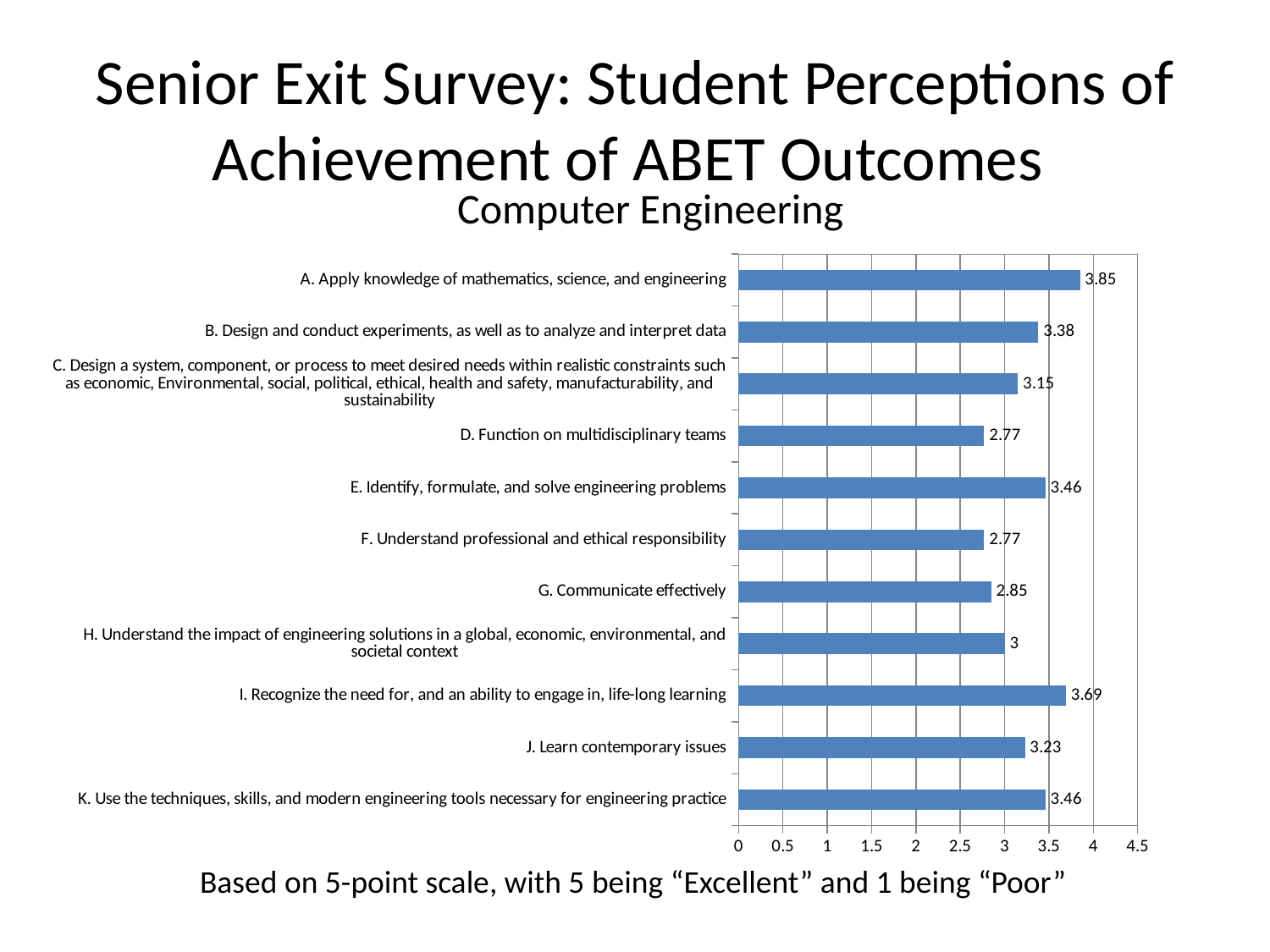
What is the value for 'J. Learn contemporary issues'? 3.23 What is the value for 'G. Communicate effectively'? 2.85 What is the value for 'D. Function on multidisciplinary teams'? 2.77 Which outcome has the highest value? A. Apply knowledge of mathematics, science, and engineering How many outcomes (categories) are plotted in the chart? 11 Is the value for 'H. Understand the impact of engineering solutions in a global, economic, environmental, and societal context' greater or less than 3.5? less What kind of chart is shown on the slide? Bar chart Which is larger, the value for 'B. Design and conduct experiments, as well as to analyze and interpret data' or the value for 'J. Learn contemporary issues'? B. Design and conduct experiments, as well as to analyze and interpret data What is the difference between the values for outcome E and outcome F? 0.69 What is the value for 'A. Apply knowledge of mathematics, science, and engineering'? 3.85 What is the difference between the values for outcome A and outcome I? 0.16 What is the maximum value shown on the horizontal axis? 4.5